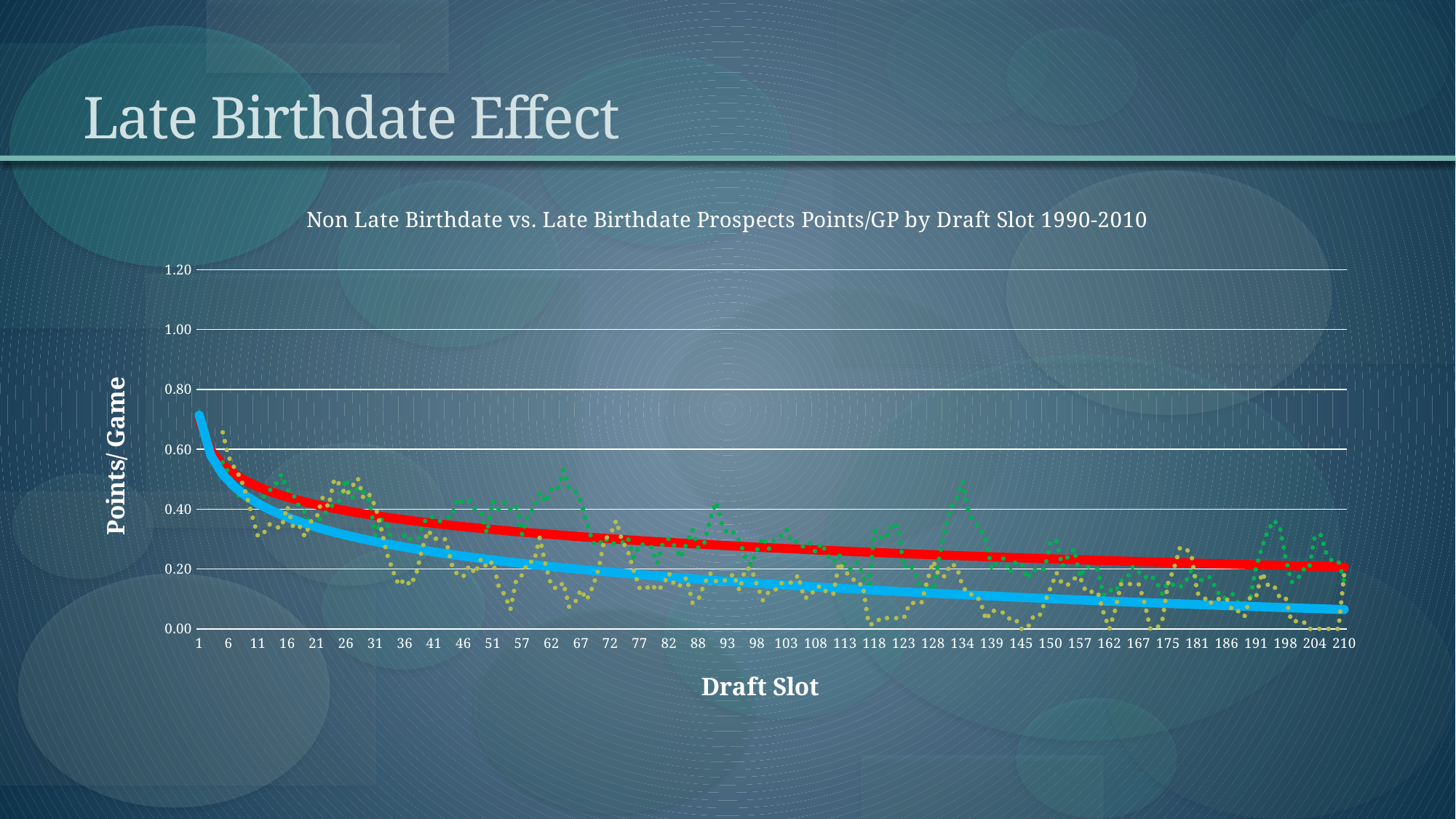
At draft slot 103, which solid trend line has the higher value, the red one or the blue one? the red one What is the label of the vertical axis? Points/ Game Is the value of the solid blue trend line at draft slot 103 greater or less than 0.40? less Is the value of the solid red trend line at draft slot 103 greater or less than 0.40? less At draft slot 210, which solid trend line has the higher value, the red one or the blue one? the red one What is the title of the chart? Non Late Birthdate vs. Late Birthdate Prospects Points/GP by Draft Slot 1990-2010 Is the value of the solid blue trend line at draft slot 1 greater or less than 0.60? greater What kind of chart is shown on the slide? line chart Do the values of the solid red trend line rise or fall as the draft slot increases? fall Do the values of the solid blue trend line rise or fall as the draft slot increases? fall